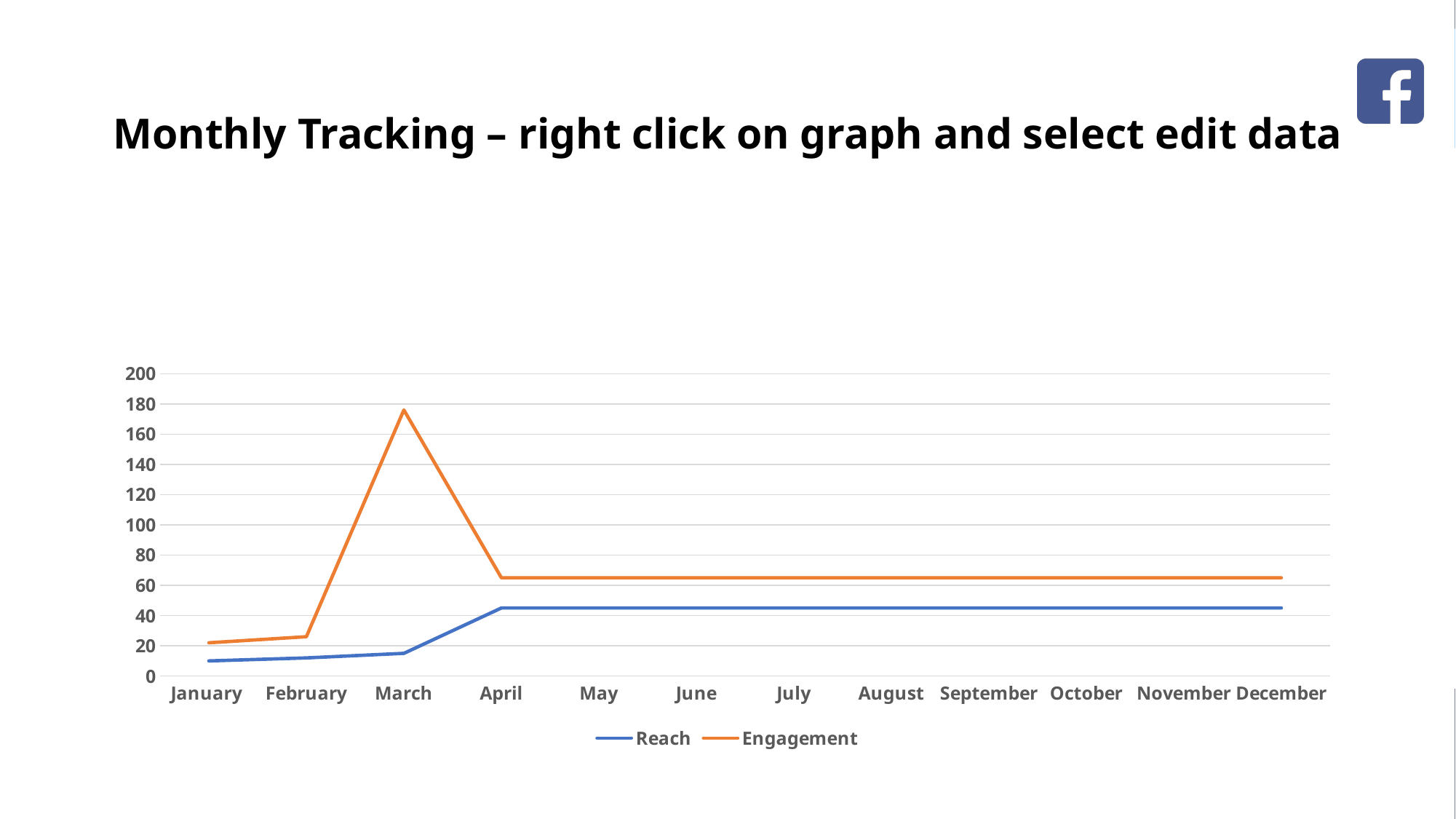
Does the Reach line rise or fall from January to April? rise Which colour is used for the Engagement series? orange Does the Engagement line rise or fall from March to April? fall What kind of chart is shown on the slide? line chart How many months are shown on the x axis? 12 In which month does Engagement reach its highest value? March How many series does the legend list? 2 Is the Reach value for January greater or less than 20? less Is the Engagement value for March greater or less than 140? greater Is the Reach value for December greater or less than 60? less Which is larger in March, Reach or Engagement? Engagement